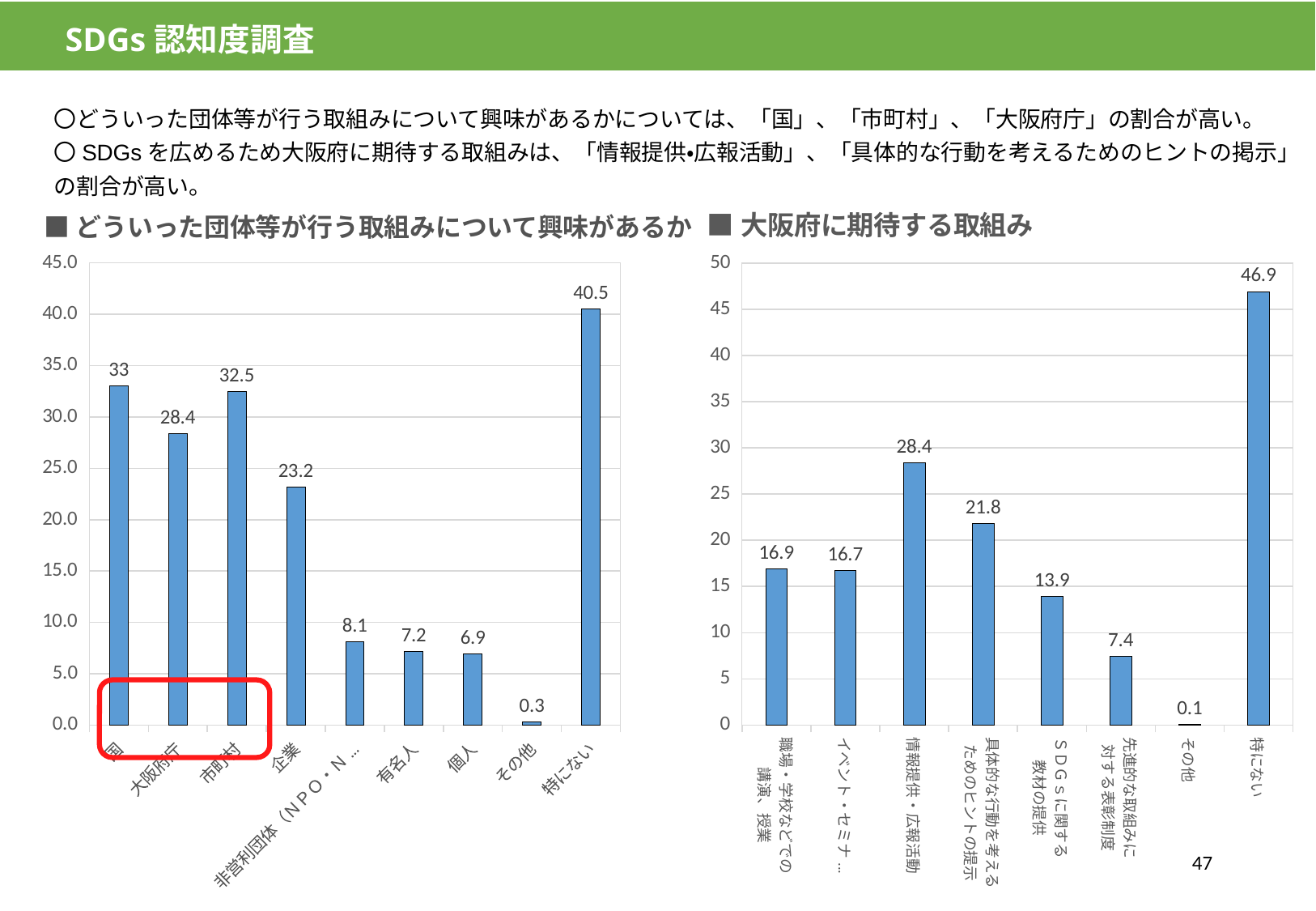
In the left chart (どういった団体等が行う取組みについて興味があるか), how many categories are shown? 9 What type of chart is the right chart (大阪府に期待する取組み)? Bar chart In the right chart (大阪府に期待する取組み), how many categories are shown? 8 In the left chart (どういった団体等が行う取組みについて興味があるか), what is the value for 国? 33 In the right chart (大阪府に期待する取組み), what is the value for 先進的な取組みに対する表彰制度? 7.4 In the right chart (大阪府に期待する取組み), which category has the highest value? 特にない In the left chart (どういった団体等が行う取組みについて興味があるか), which category has the lowest value? その他 In the left chart (どういった団体等が行う取組みについて興味があるか), what is the value for 企業? 23.2 In the right chart (大阪府に期待する取組み), which is larger, 情報提供・広報活動 or 具体的な行動を考えるためのヒントの提示? 情報提供・広報活動 In the left chart (どういった団体等が行う取組みについて興味があるか), which category has the highest value? 特にない In the right chart (大阪府に期待する取組み), what is the value for 情報提供・広報活動? 28.4 In the left chart (どういった団体等が行う取組みについて興味があるか), what is the difference between the values for 国 and 大阪府庁? 4.6